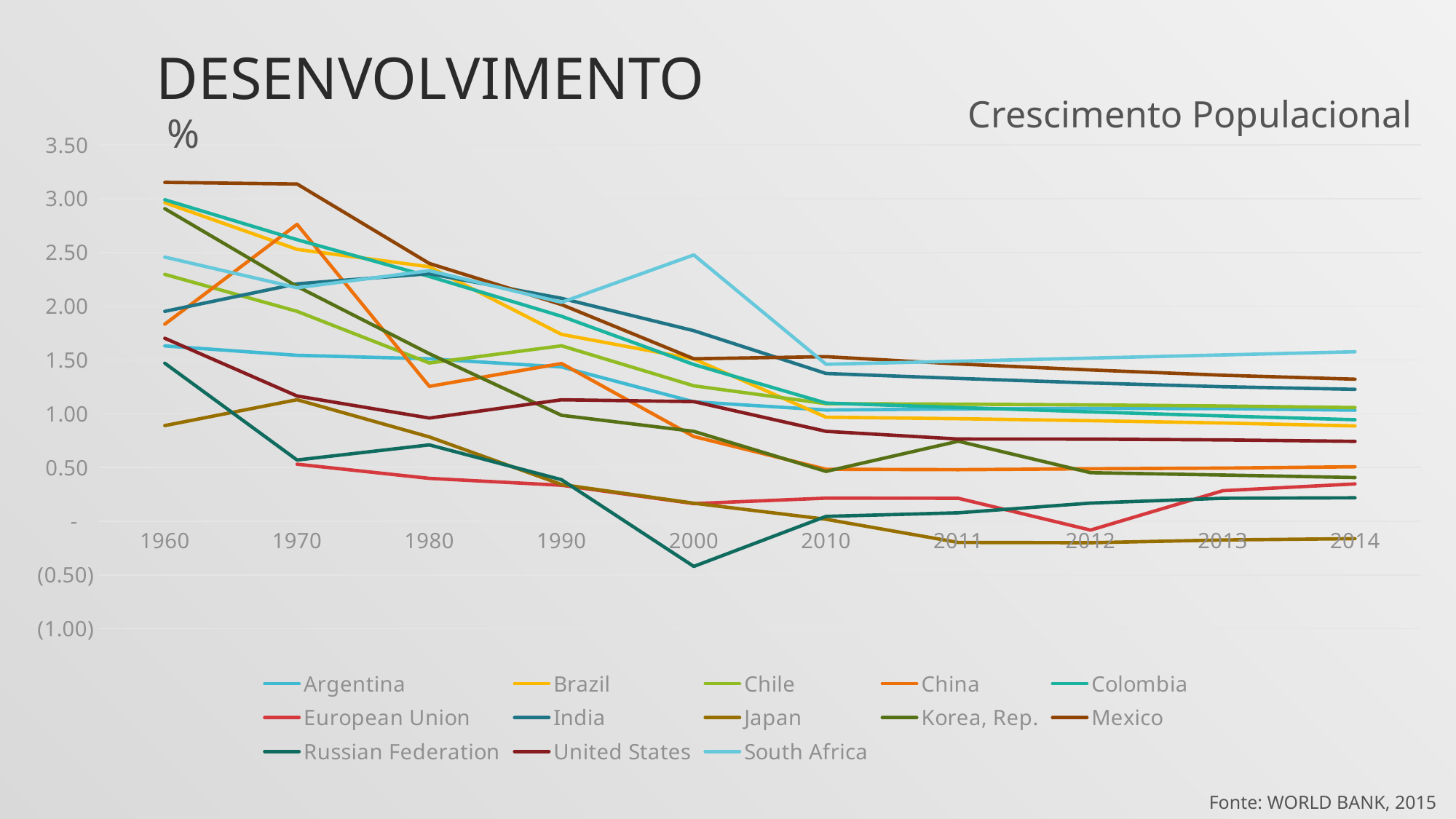
Which series has the lowest value in 2014? Japan How many years are shown along the x axis? 10 What is the title of the chart? Crescimento Populacional Which series has the highest value in 1960? Mexico Does the value for Mexico rise or fall from 1960 to 2014? fall Is the value for South Africa in 2000 greater or less than 2.00? greater How many series does the legend list? 13 Is the value for Mexico in 1960 greater or less than 3.00? greater Which series has the lowest value in 2000? Russian Federation Which is larger in 2014, the value for Russian Federation or the value for Japan? Russian Federation What kind of chart is shown on the slide? line chart Is the value for Japan in 2014 greater or less than 0.50? less